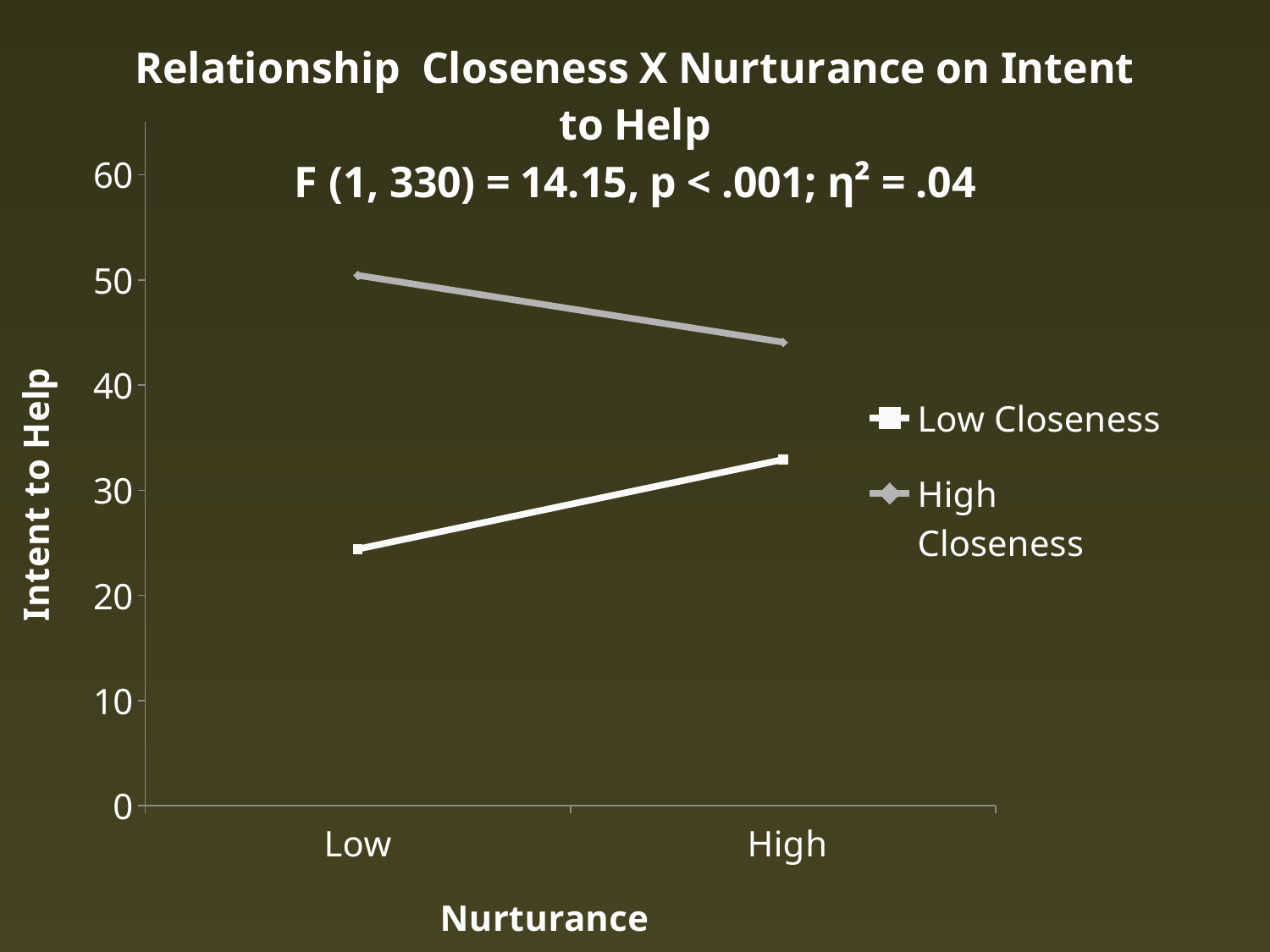
How many series does the legend list? 2 Is the value for Low Closeness at High Nurturance greater or less than 40? less Which series and category combination has the lowest Intent to Help value? Low Closeness at Low Nurturance What kind of chart is shown on the slide? line chart What is the label of the y axis? Intent to Help Does the Low Closeness line rise or fall from Low to High Nurturance? rise How many categories are shown on the x axis? 2 What is the label of the x axis? Nurturance Which series has the higher value at High Nurturance, Low Closeness or High Closeness? High Closeness Does the High Closeness line rise or fall from Low to High Nurturance? fall Is the value for High Closeness at Low Nurturance greater or less than 40? greater Is the value for Low Closeness at Low Nurturance greater or less than 30? less